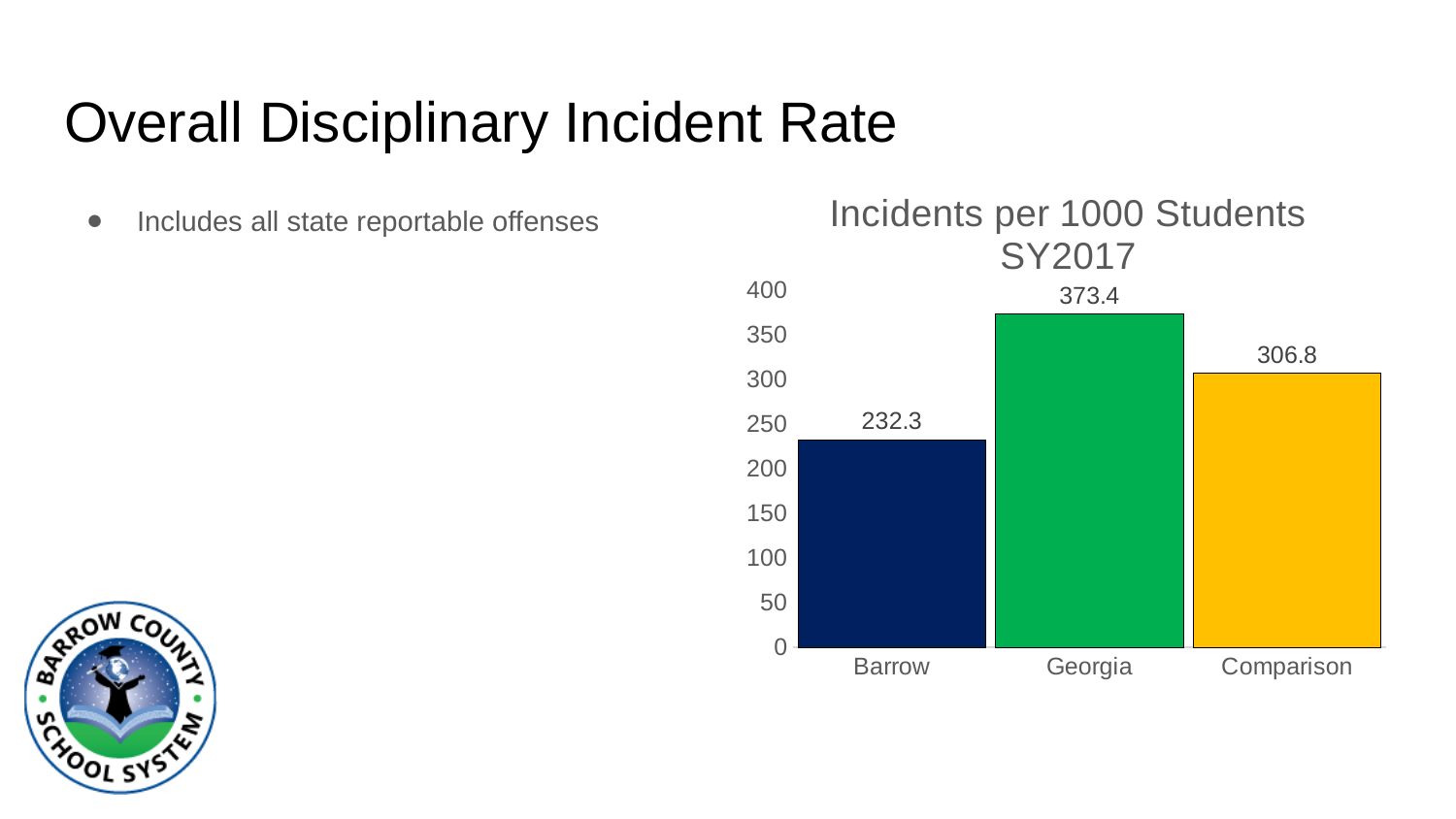
What is the difference between the Georgia and Barrow values? 141.1 What is the title of the chart? Incidents per 1000 Students SY2017 Which is larger, the value for Comparison or the value for Barrow? Comparison Is the value for Barrow greater or less than 250? less What kind of chart is shown on the slide? bar chart What is the value for Georgia in the chart? 373.4 Which category has the highest incidents per 1000 students? Georgia What is the value for Barrow in the chart? 232.3 What is the value for Comparison in the chart? 306.8 Which category has the lowest incidents per 1000 students? Barrow How many categories are shown in the chart? 3 What is the difference between the Comparison and Barrow values? 74.5